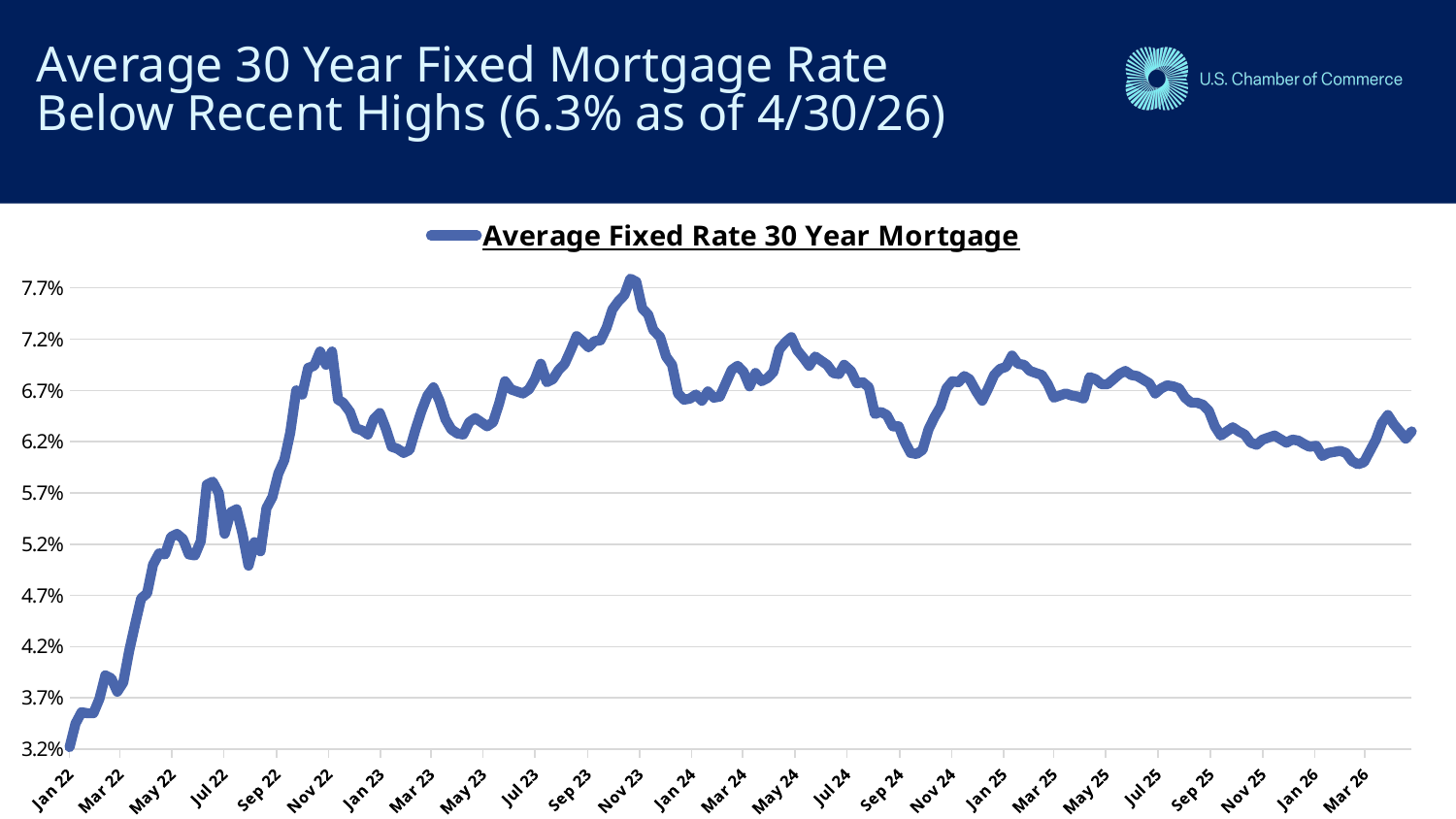
At which x-axis label is the mortgage rate at its lowest? Jan 22 Which is higher, the mortgage rate at Nov 22 or at Sep 24? Nov 22 Is the mortgage rate at Sep 24 greater or less than 6.7%? less According to the slide title, what was the average 30 year fixed mortgage rate as of 4/30/26? 6.3% How many series does the legend list? 1 Does the mortgage rate rise or fall between Jan 22 and Nov 22? Rise How many labels are shown on the x axis? 26 Is the mortgage rate at Jan 22 greater or less than 3.7%? less What kind of chart is shown on the slide? Line chart Around which x-axis label does the mortgage rate reach its highest point? Nov 23 What is the legend entry for the plotted series? Average Fixed Rate 30 Year Mortgage Is the peak mortgage rate around Nov 23 greater or less than 7.2%? greater